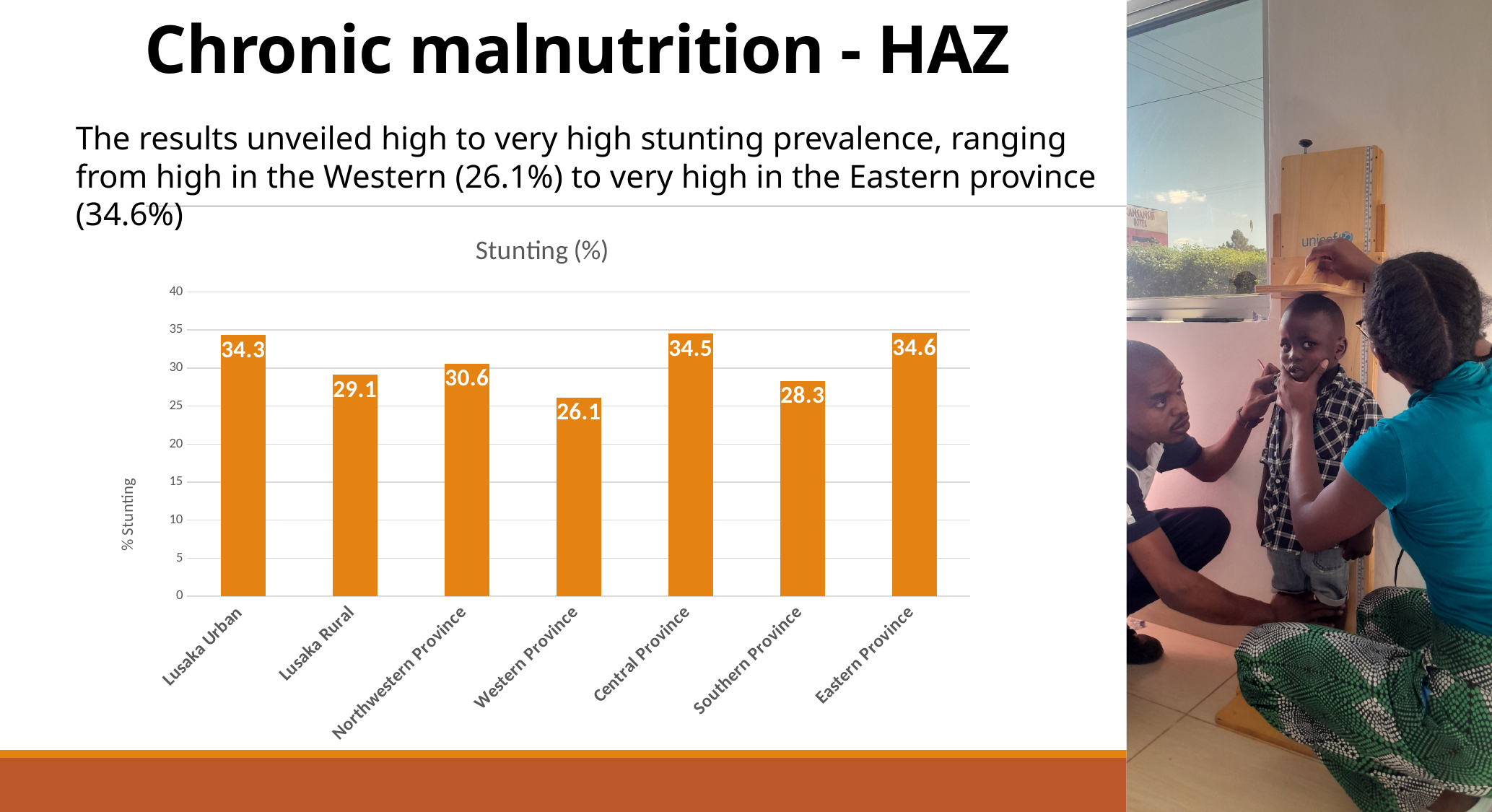
What is the difference between the stunting values for Lusaka Urban and Lusaka Rural? 5.2 Which has a higher stunting value, Northwestern Province or Lusaka Rural? Northwestern Province Which category has the highest stunting value? Eastern Province Is the stunting value for Western Province greater or less than 30? less How many categories are shown on the x axis of the chart? 7 What is the stunting value for Southern Province? 28.3 Which province has the lowest stunting value? Western Province What is the stunting value for Lusaka Urban? 34.3 What is the stunting value for Western Province? 26.1 What is the title of the chart? Stunting (%) What kind of chart is shown on the slide? bar chart What is the difference between the stunting values for Eastern Province and Western Province? 8.5